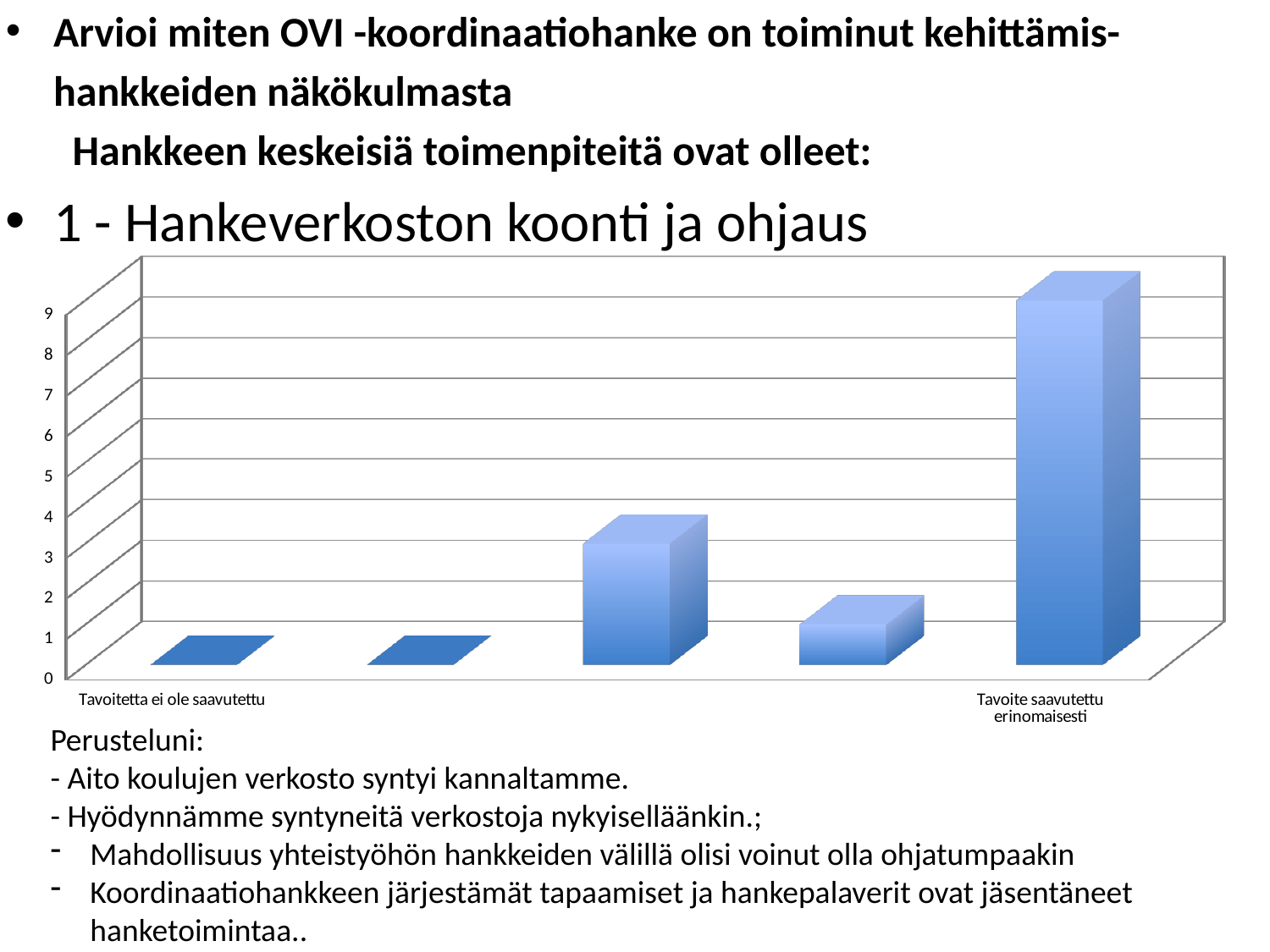
Is the value of the third bar from the left greater or less than 2? greater What is the highest value shown on the vertical axis? 9 Is the value for "Tavoite saavutettu erinomaisesti" greater or less than 5? greater What is the value for "Tavoitetta ei ole saavutettu"? 0 How many bars are plotted in the chart? 5 Is the value for "Tavoitetta ei ole saavutettu" greater or less than 1? less Which category has the highest bar in the chart? Tavoite saavutettu erinomaisesti Which is larger, the third bar from the left or the fourth bar from the left? the third bar What colour are the bars in the chart? blue What kind of chart is shown on the slide? bar chart Which is larger, the value for "Tavoitetta ei ole saavutettu" or the value for "Tavoite saavutettu erinomaisesti"? Tavoite saavutettu erinomaisesti